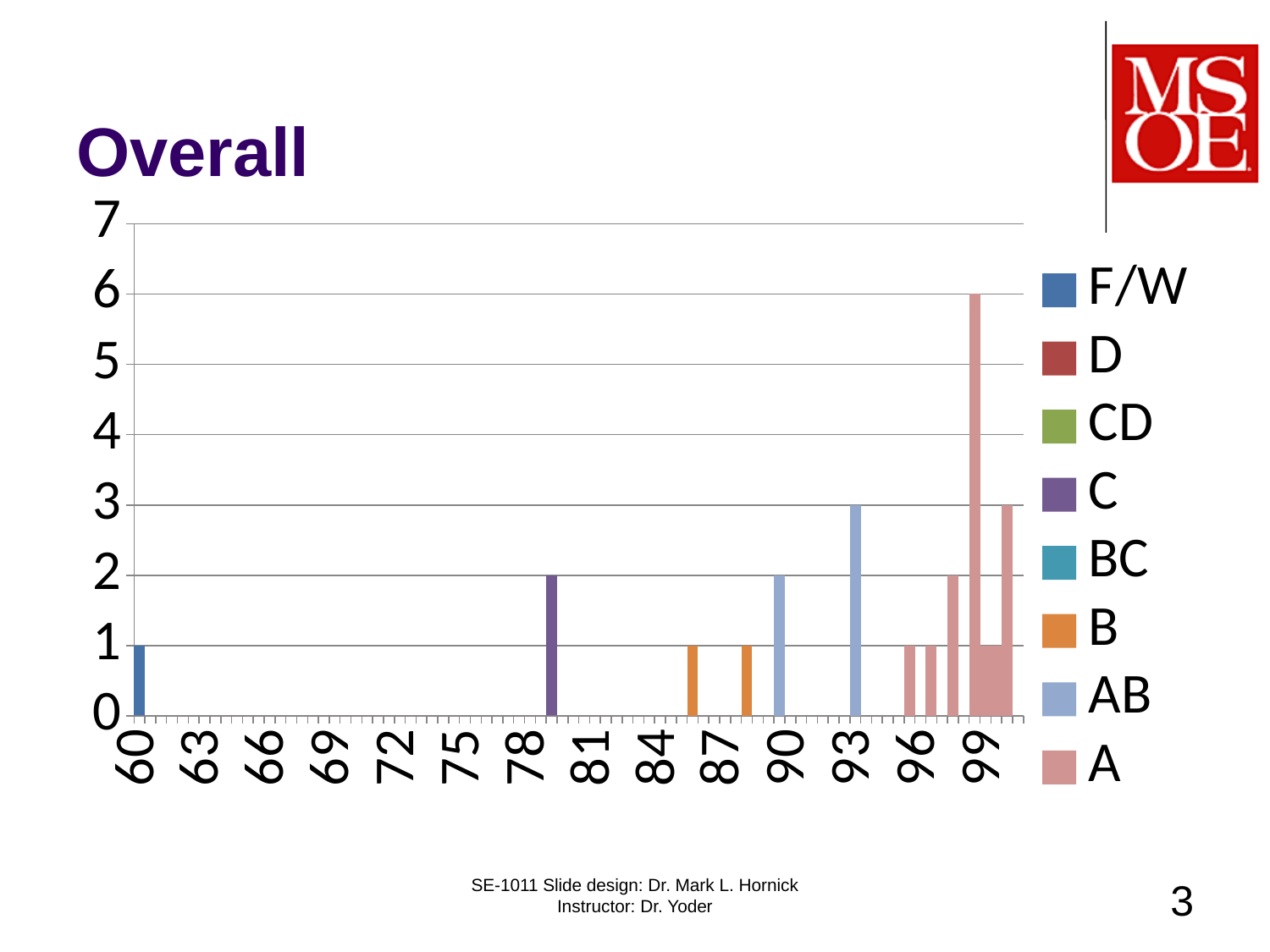
What type of chart is shown on the slide? bar chart How many series does the legend list? 8 What is the title of the chart? Overall What is the difference between the AB bar at 93 and the F/W bar at 60? 2 Which series has the tallest bar in the chart? A What is the value of the AB bar at 90? 2 Which is larger, the AB bar at 93 or the AB bar at 90? the AB bar at 93 Is the tallest bar in the chart greater or less than 5? greater Which legend entry is listed last? A What is the value of the AB bar at 93? 3 What is the height of the tallest bar in the chart? 6 What is the value of the F/W bar at 60? 1